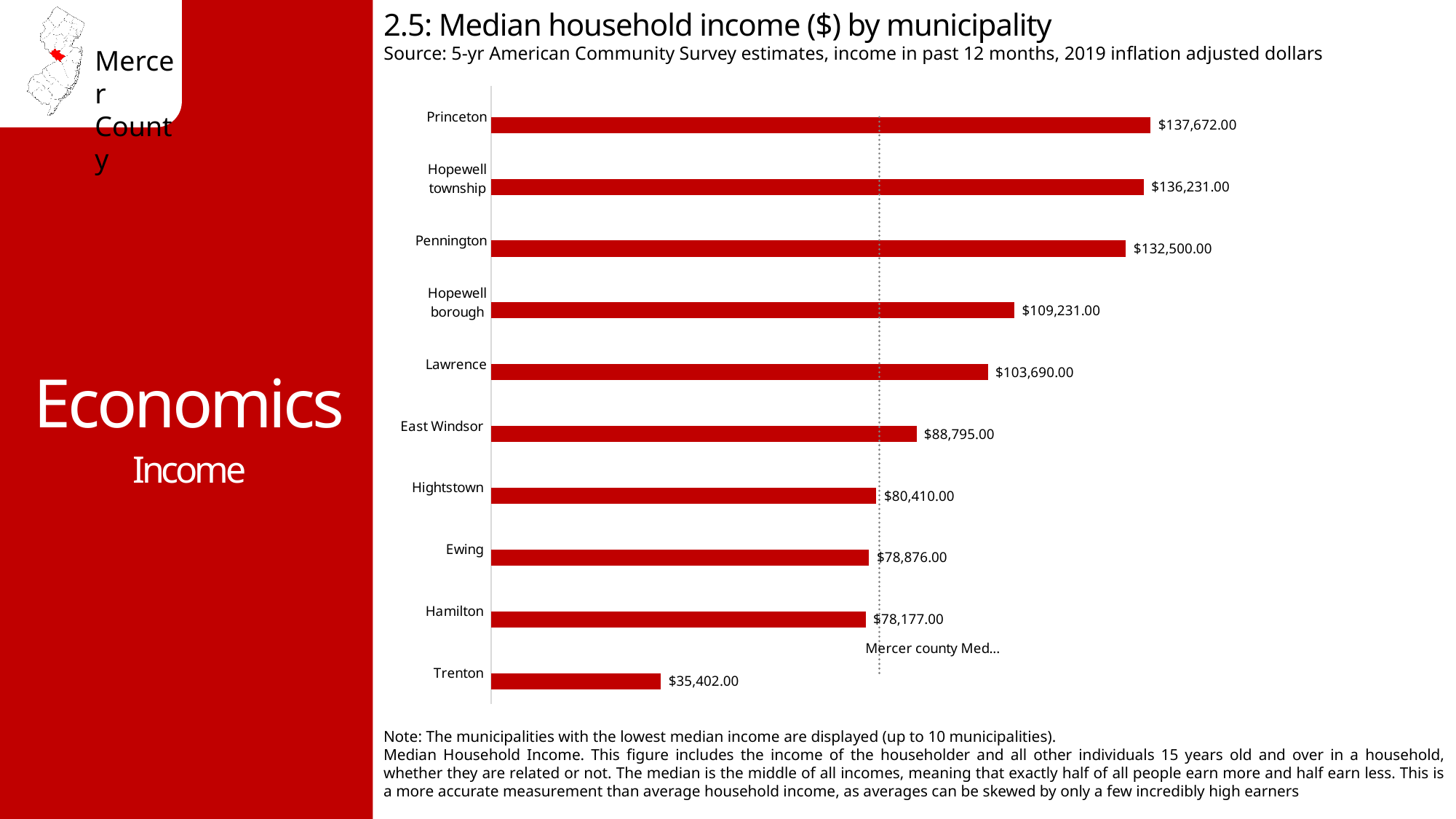
What is the difference in median household income between Pennington and Lawrence? $28,810.00 What is the median household income for Princeton? $137,672.00 Which has a higher median household income, Hopewell borough or East Windsor? Hopewell borough What is the median household income for Hightstown? $80,410.00 Which municipality has the highest median household income? Princeton Which municipality has the lowest median household income? Trenton What is the title of the chart? 2.5: Median household income ($) by municipality What is the median household income for Trenton? $35,402.00 What is the difference in median household income between Princeton and Trenton? $102,270.00 How many municipalities are shown in the chart? 10 What is the median household income for Lawrence? $103,690.00 What kind of chart is used to show median household income by municipality? Bar chart